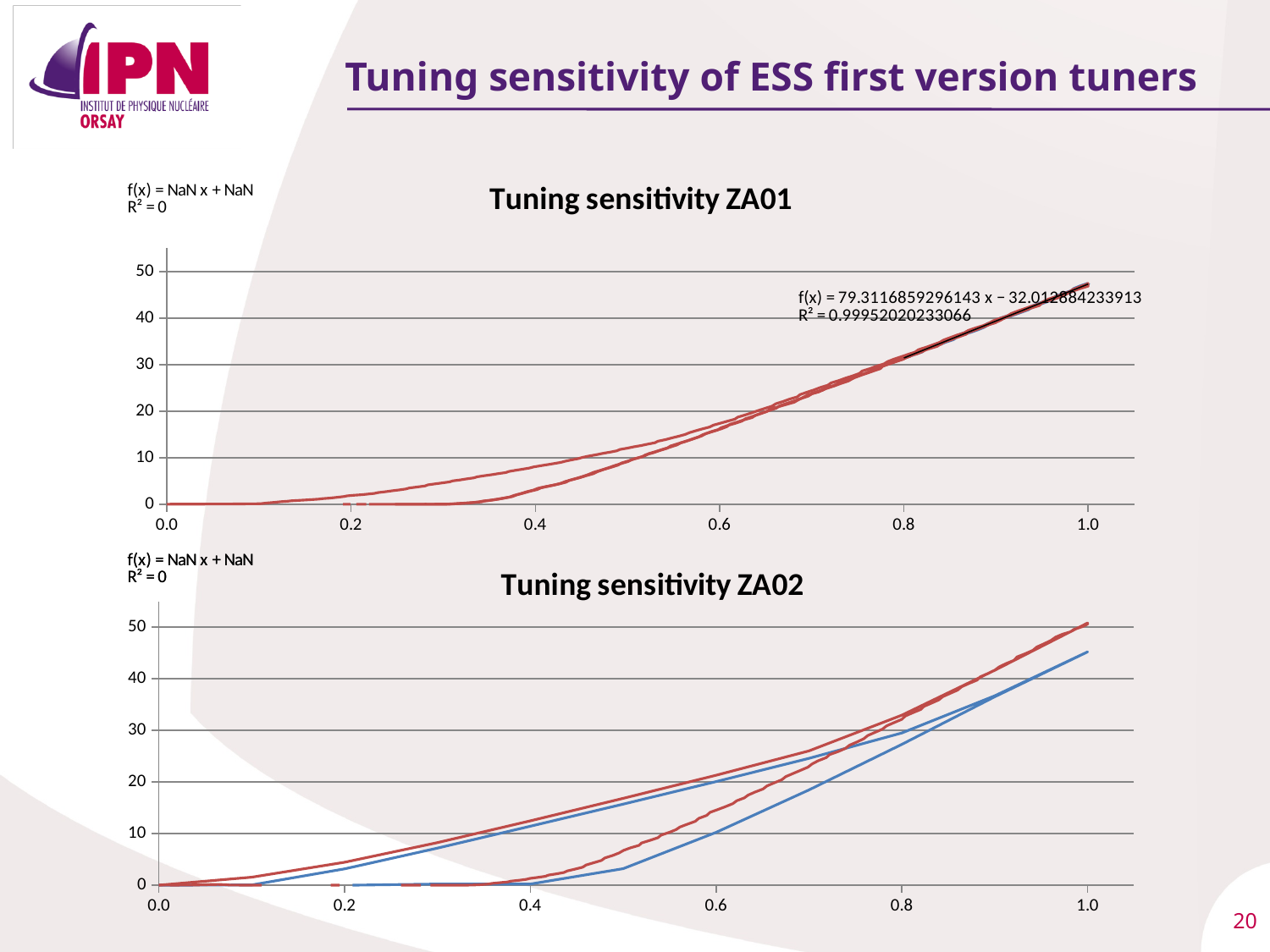
How many charts are shown on the slide? 2 In the "Tuning sensitivity ZA02" chart, do the values rise or fall as x increases from 0.6 to 1.0? rise In the "Tuning sensitivity ZA02" chart, at x = 1.0, which line reaches the higher value, the red line or the blue line? the red line What kind of chart is the "Tuning sensitivity ZA01" chart? line chart What R² value is printed for the fitted trendline in the "Tuning sensitivity ZA01" chart? 0.99952020233066 What is the title of the lower chart on the slide? Tuning sensitivity ZA02 What is the slope of the fitted trendline equation shown in the "Tuning sensitivity ZA01" chart? 79.3116859296143 In the "Tuning sensitivity ZA01" chart, do the values rise or fall as x increases from 0.4 to 1.0? rise In the "Tuning sensitivity ZA02" chart, is the value of the blue line at x = 0.6 greater or less than 30? less In the "Tuning sensitivity ZA02" chart, is the value of the red line at x = 1.0 greater or less than 40? greater In the "Tuning sensitivity ZA01" chart, is the value at x = 0.2 greater or less than 10? less